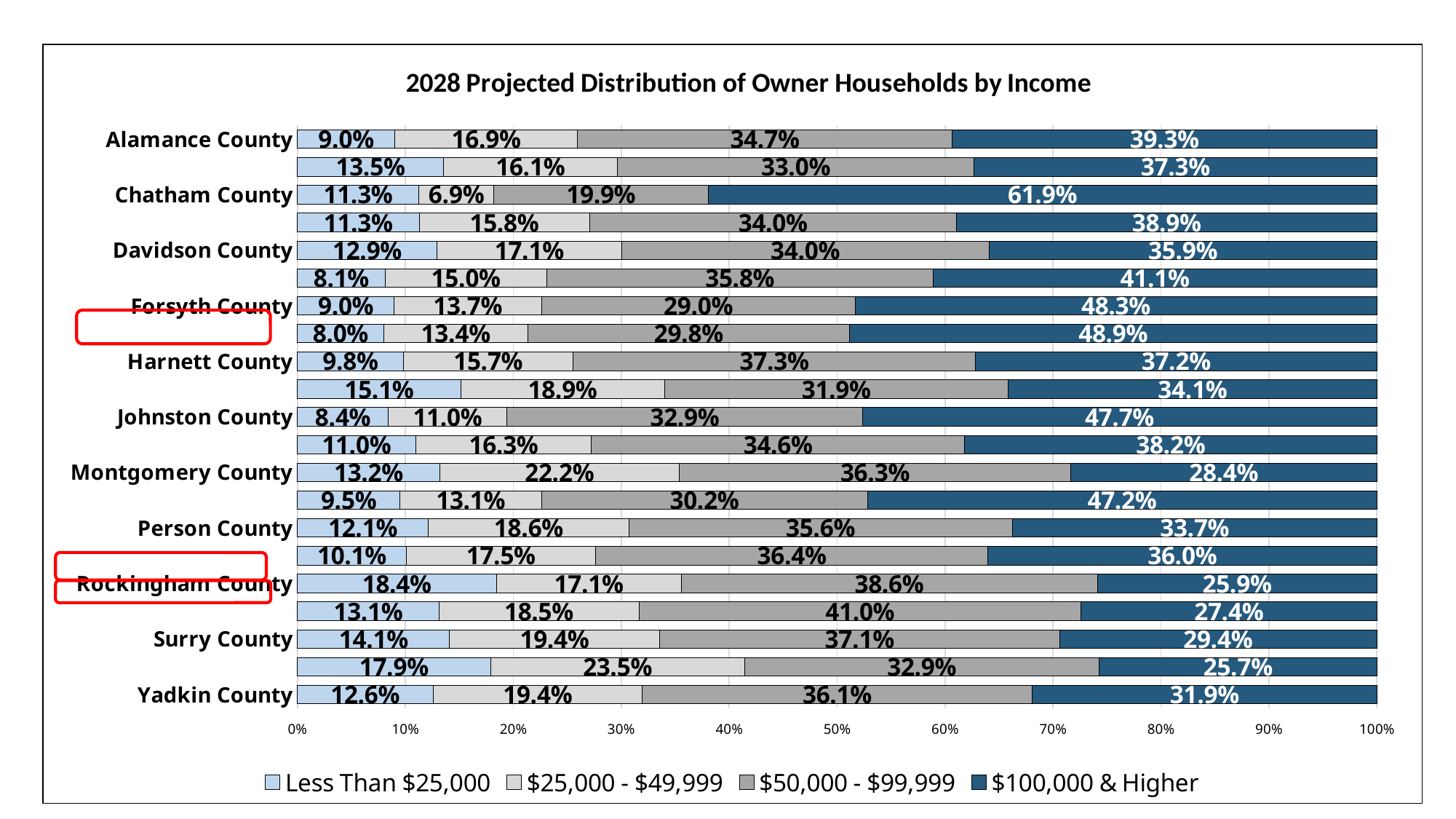
What is the title of the chart? 2028 Projected Distribution of Owner Households by Income What kind of chart is shown on the slide? Stacked bar chart What is the $25,000 - $49,999 value for Montgomery County? 22.2% What is the difference between the $100,000 & Higher values for Chatham County and Alamance County? 22.6 percentage points What is the difference between the Less Than $25,000 values for Rockingham County and Alamance County? 9.4 percentage points What share of owner households in Alamance County are projected to have income Less Than $25,000? 9.0% Which county has the highest value for the $100,000 & Higher series? Chatham County What is the $50,000 - $99,999 value for Rockingham County? 38.6% Which has a larger $100,000 & Higher value, Forsyth County or Surry County? Forsyth County What is the value for the $100,000 & Higher series for Chatham County? 61.9% Which has a larger $25,000 - $49,999 value, Montgomery County or Johnston County? Montgomery County How many series does the legend list? 4